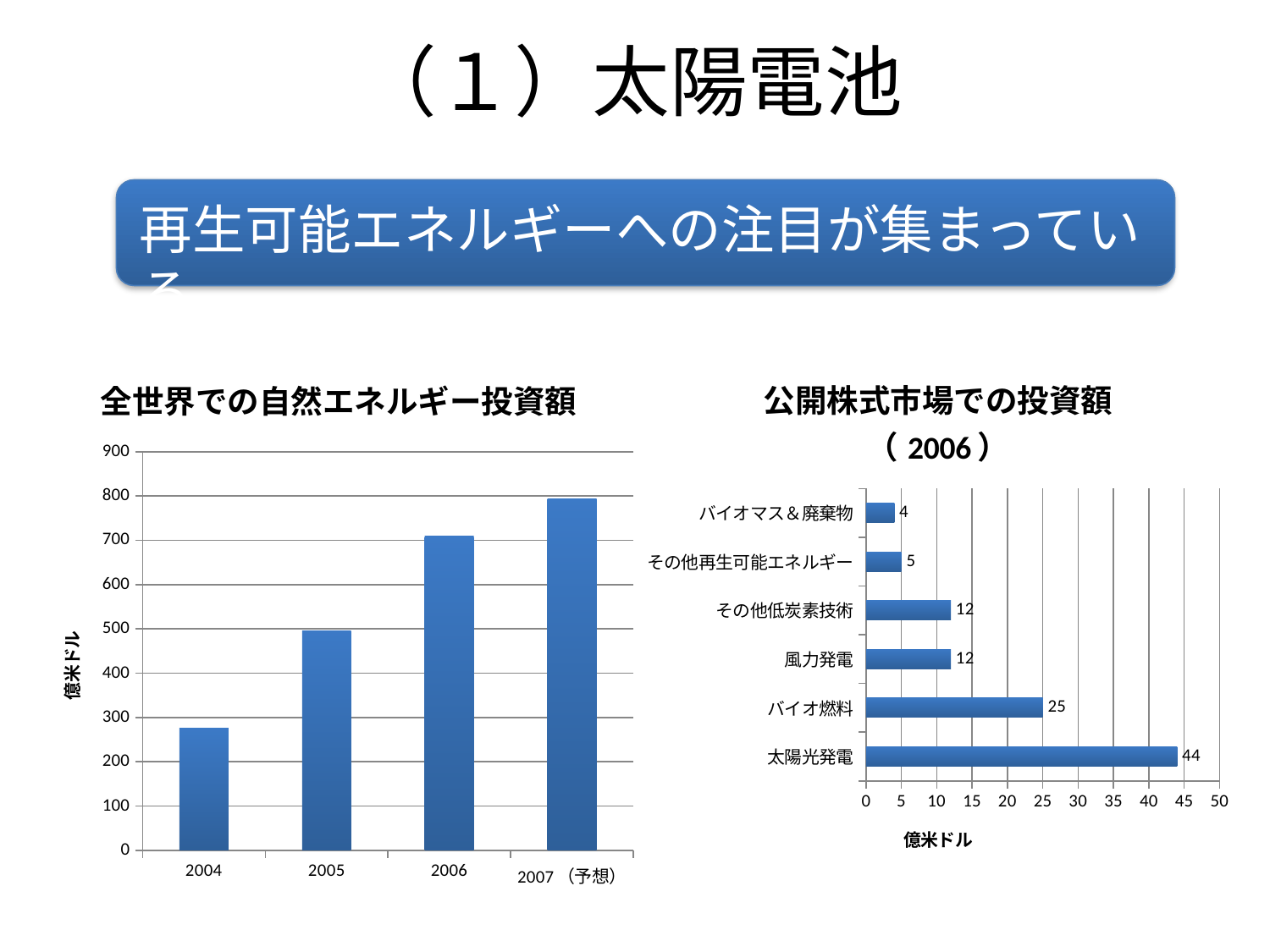
In the chart titled 公開株式市場での投資額（2006）, what is the value for 太陽光発電? 44 In the chart titled 公開株式市場での投資額（2006）, what is the value for バイオマス＆廃棄物? 4 In the chart titled 公開株式市場での投資額（2006）, which category has the lowest value? バイオマス＆廃棄物 In the chart titled 全世界での自然エネルギー投資額, what is the label on the vertical axis? 億米ドル In the chart titled 公開株式市場での投資額（2006）, what is the value for バイオ燃料? 25 In the chart titled 全世界での自然エネルギー投資額, is the value for 2004 greater or less than 300? less What kind of chart is the one titled 全世界での自然エネルギー投資額? bar chart In the chart titled 全世界での自然エネルギー投資額, do the values rise or fall from 2004 to 2007? rise In the chart titled 公開株式市場での投資額（2006）, which is larger, その他再生可能エネルギー or その他低炭素技術? その他低炭素技術 In the chart titled 公開株式市場での投資額（2006）, how many categories are shown? 6 In the chart titled 公開株式市場での投資額（2006）, which category has the highest value? 太陽光発電 In the chart titled 公開株式市場での投資額（2006）, what is the difference between the values for 太陽光発電 and バイオ燃料? 19